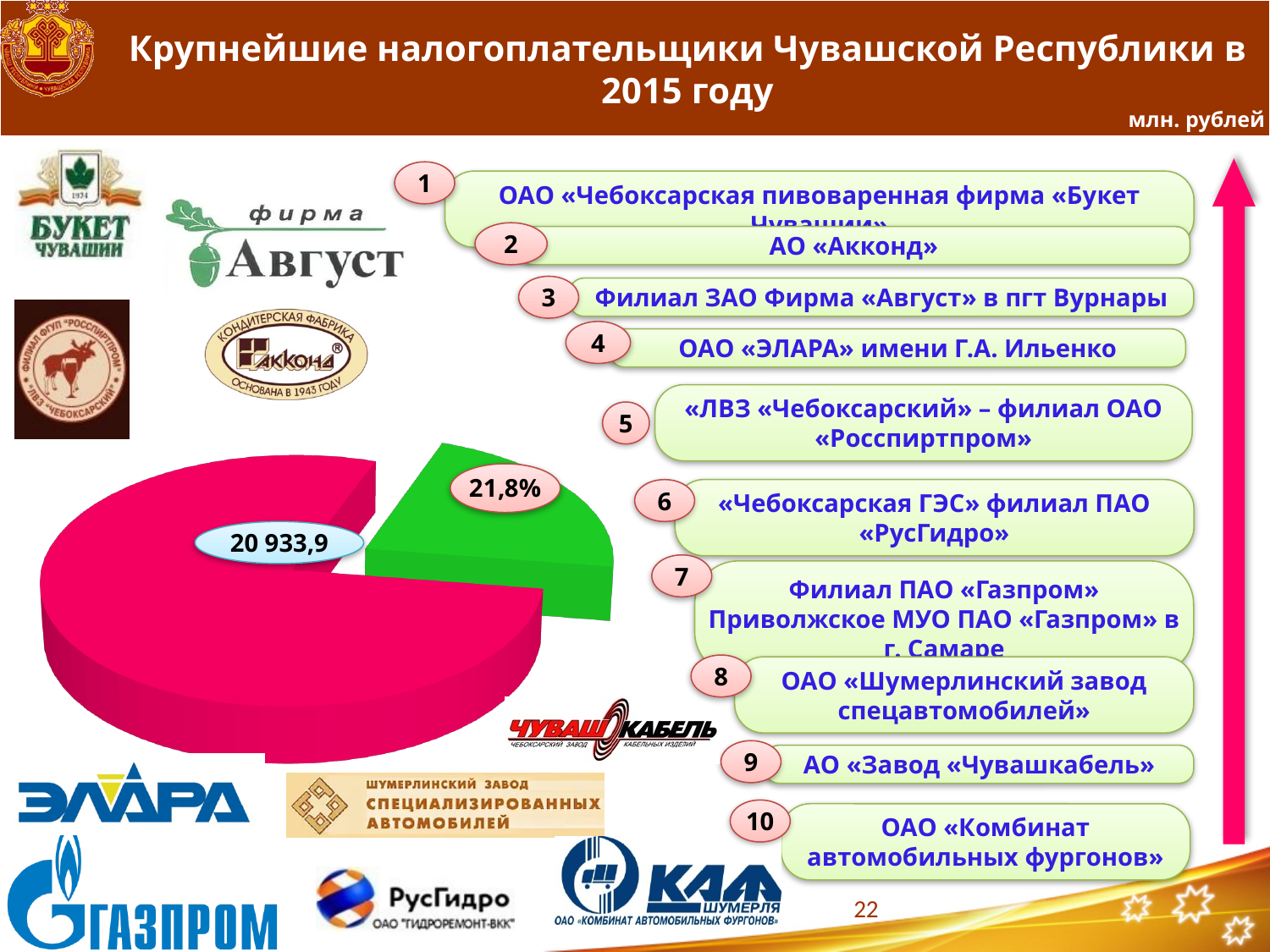
What unit is indicated for the values on the slide? млн. рублей What percentage is printed on the green slice of the pie chart? 21,8% What kind of chart is shown on the slide? pie chart What value is printed in the centre of the pie chart? 20 933,9 What colour is the exploded (separated) slice of the pie chart? green How many slices does the pie chart have? 2 Is the share of the green slice greater or less than 50%? less Which slice of the pie chart is larger, the pink one or the green one? the pink one